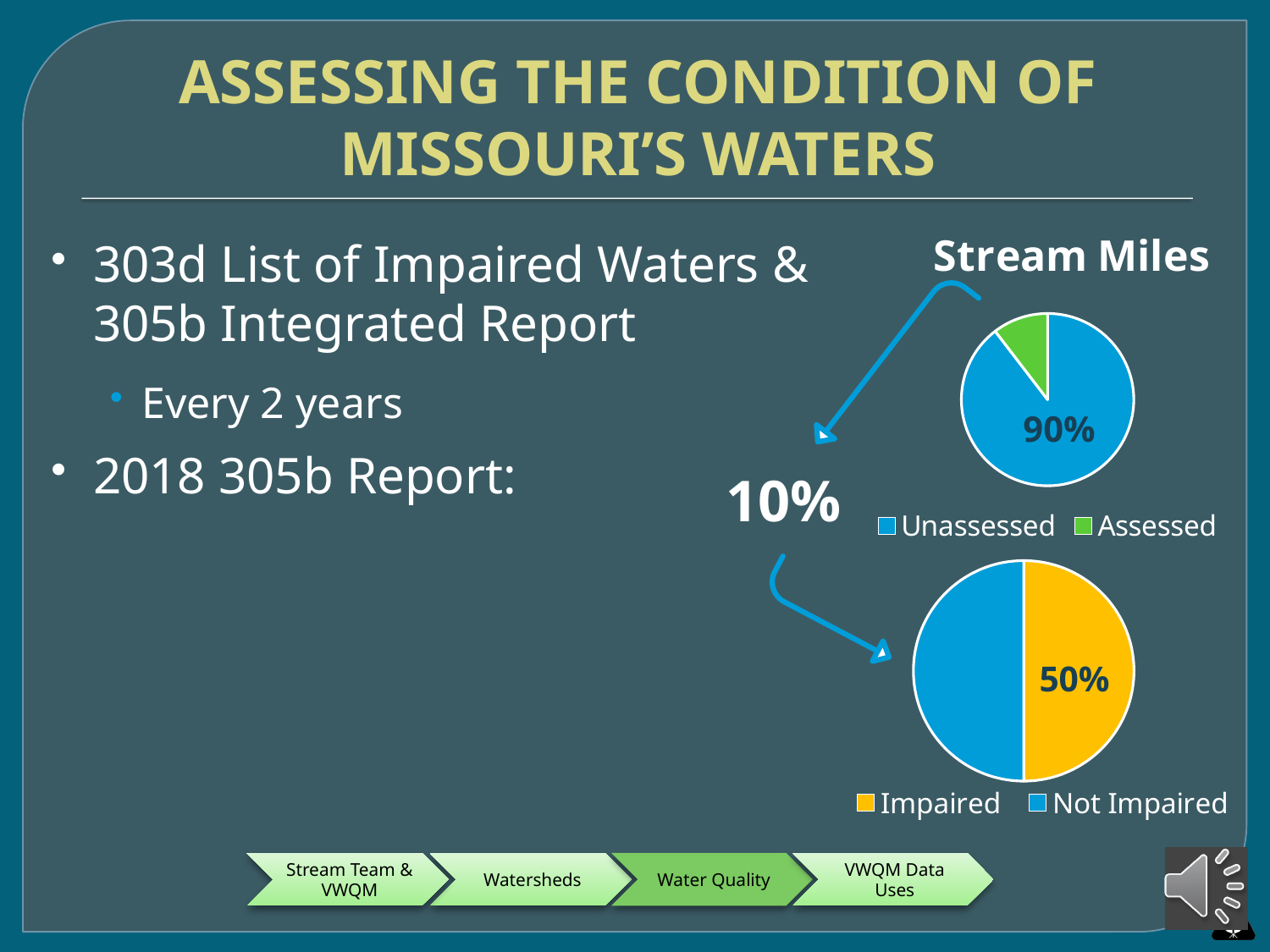
In the Stream Miles pie chart, what is the difference in percentage points between Unassessed and Assessed? 80 In the lower pie chart, what percentage is labelled for Impaired? 50% In the Stream Miles pie chart, which category has the smallest share? Assessed In the Stream Miles pie chart, which category has the largest share? Unassessed In the Stream Miles pie chart, what percentage of stream miles is Unassessed? 90% In the lower pie chart, what colour represents the Impaired slice? Yellow What type of chart is the Stream Miles chart? Pie chart In the Stream Miles pie chart, which is larger, Unassessed or Assessed? Unassessed In the Stream Miles pie chart, what colour represents the Assessed slice? Green How many categories does the Stream Miles pie chart show? 2 How many categories does the lower pie chart (Impaired / Not Impaired) show? 2 In the Stream Miles pie chart, what percentage of stream miles is Assessed? 10%